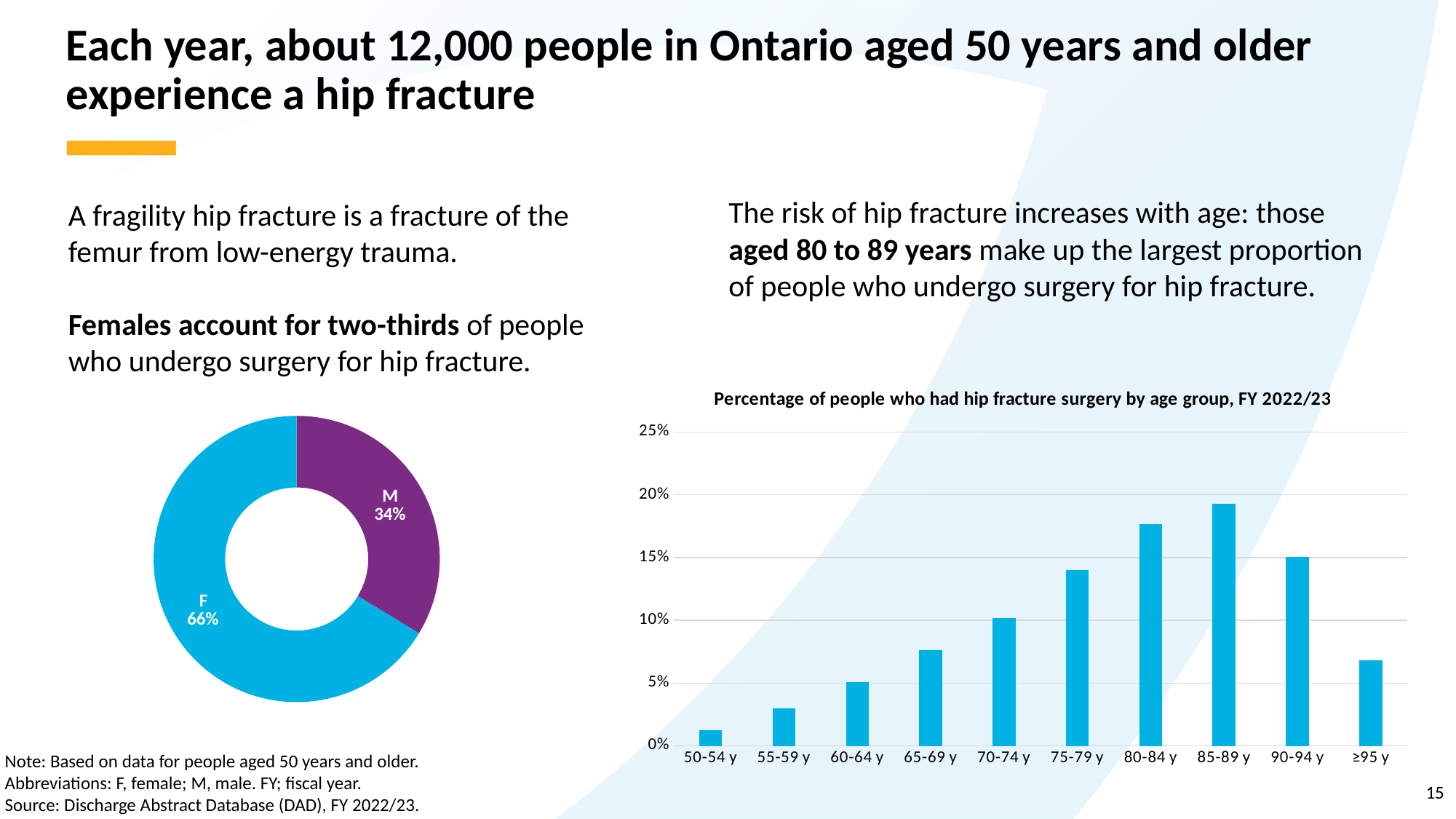
In the donut chart on the left, how many percentage points larger is the F share than the M share? 32 percentage points In the chart titled 'Percentage of people who had hip fracture surgery by age group, FY 2022/23', is the value for ≥95 y greater or less than 5%? greater In the chart titled 'Percentage of people who had hip fracture surgery by age group, FY 2022/23', is the value for 85-89 y greater or less than 15%? greater In the chart titled 'Percentage of people who had hip fracture surgery by age group, FY 2022/23', how many age groups are shown on the x axis? 10 In the chart titled 'Percentage of people who had hip fracture surgery by age group, FY 2022/23', is the value for 50-54 y greater or less than 5%? less In the donut chart on the left, what percentage is shown for M (male)? 34% In the chart titled 'Percentage of people who had hip fracture surgery by age group, FY 2022/23', which has the larger value, 80-84 y or 90-94 y? 80-84 y In the donut chart on the left, which segment is larger, F or M? F In the donut chart on the left, what percentage is shown for F (female)? 66% In the chart titled 'Percentage of people who had hip fracture surgery by age group, FY 2022/23', which age group has the highest bar? 85-89 y What kind of chart is the one titled 'Percentage of people who had hip fracture surgery by age group, FY 2022/23'? Bar chart In the chart titled 'Percentage of people who had hip fracture surgery by age group, FY 2022/23', which age group has the lowest bar? 50-54 y